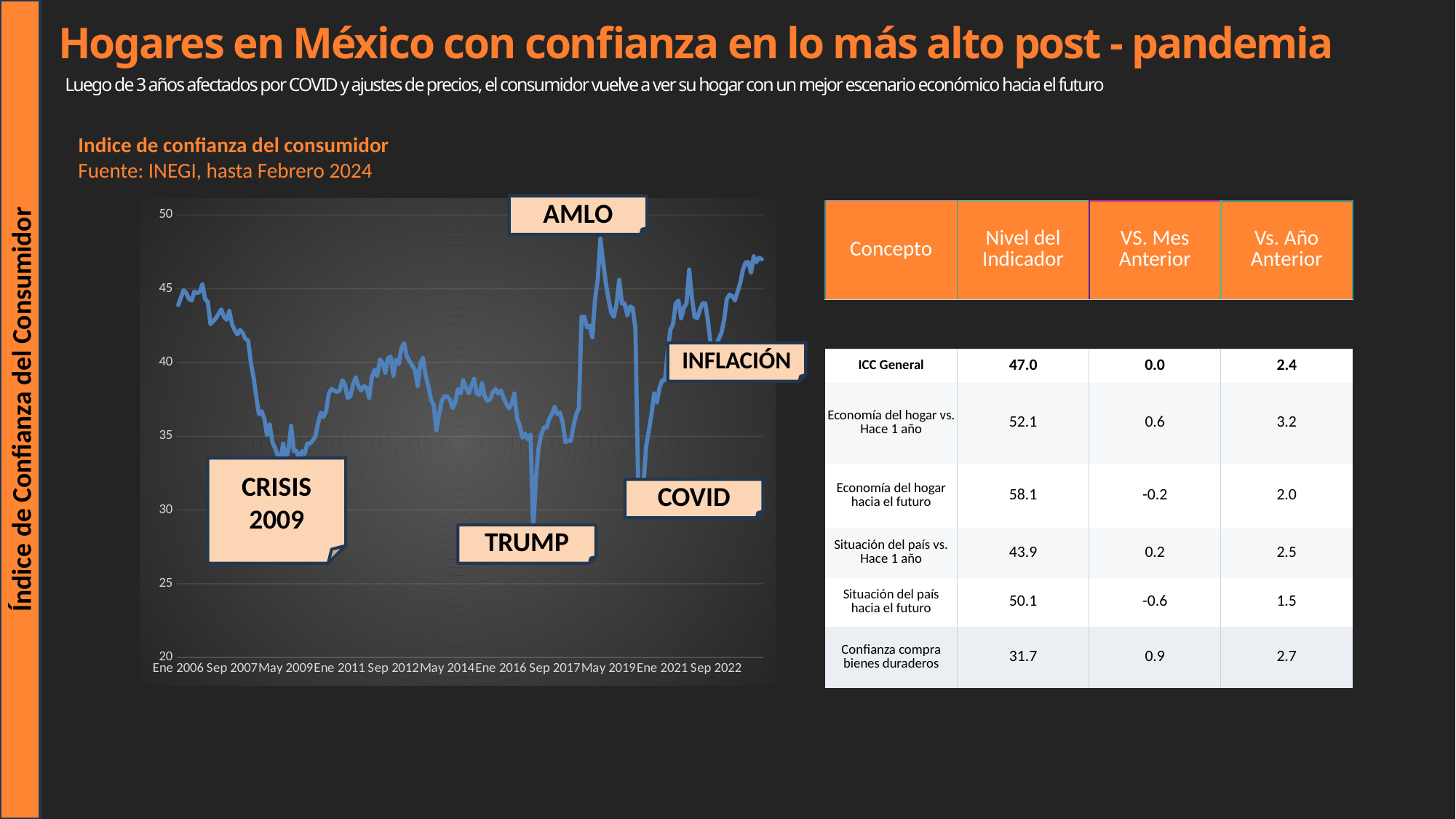
Between Ene 2006 and May 2009, does the index rise or fall? fall What is the title of the chart? Indice de confianza del consumidor Is the value of the index at the end of the series (right edge of the chart) greater or less than 45? greater Is the value of the index at the peak labelled AMLO greater or less than 45? greater Is the value of the index at Ene 2006 greater or less than 40? greater How many annotation boxes are placed on the chart? 5 Which is higher: the peak labelled AMLO or the low point labelled CRISIS 2009? AMLO How many date labels are shown on the x axis of the chart? 11 What kind of chart is shown on the left of the slide? line chart